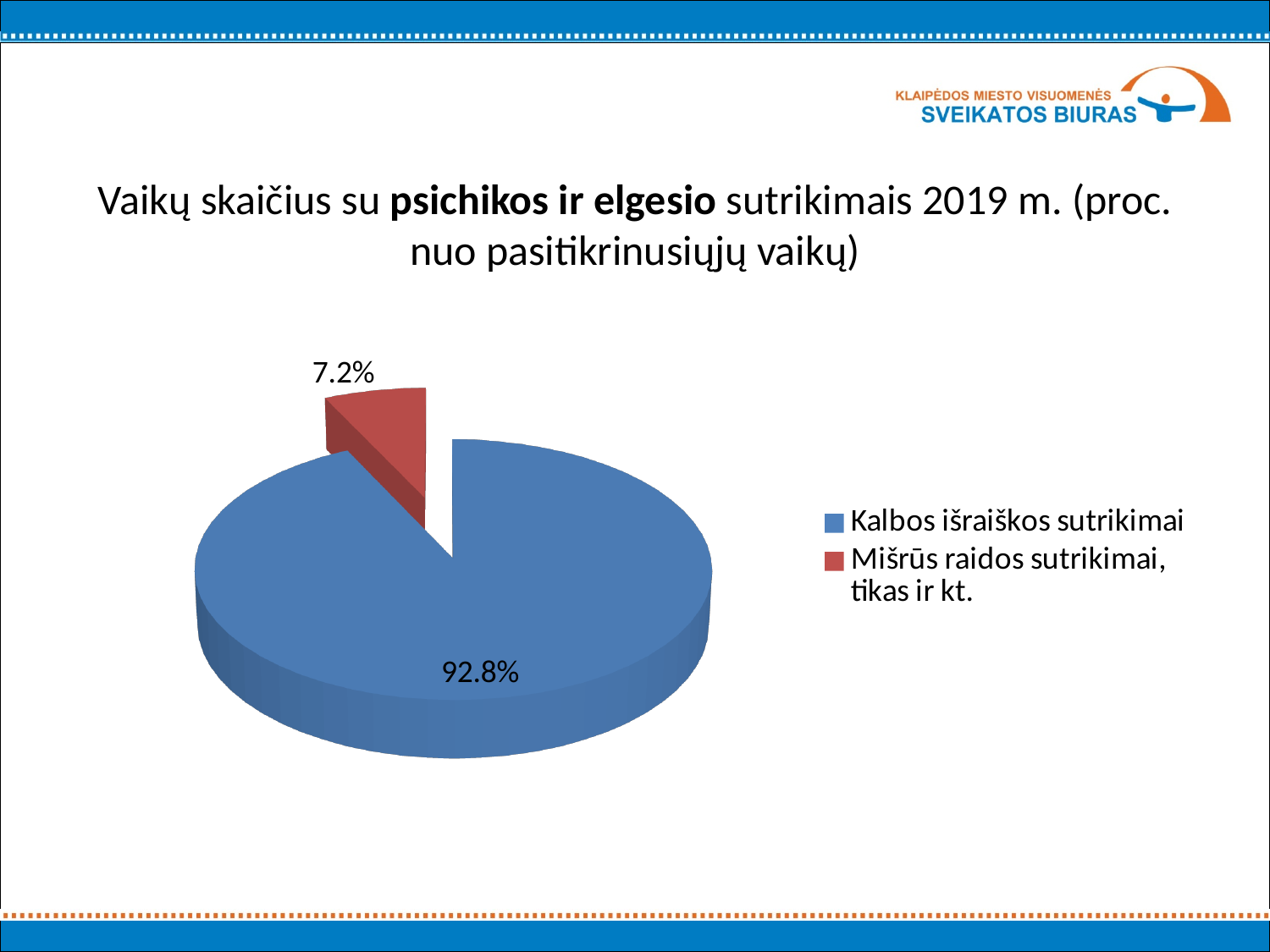
Which category has the largest slice of the pie? Kalbos išraiškos sutrikimai What colour is the slice for "Mišrūs raidos sutrikimai, tikas ir kt."? red Which year does the chart title refer to? 2019 Which category has the smallest slice of the pie? Mišrūs raidos sutrikimai, tikas ir kt. How many slices does the pie chart have? 2 How many entries does the legend list? 2 Which is larger: the slice for "Kalbos išraiškos sutrikimai" or the slice for "Mišrūs raidos sutrikimai, tikas ir kt."? Kalbos išraiškos sutrikimai What share of the pie does "Kalbos išraiškos sutrikimai" take? 92.8% What is the difference in percentage points between the "Kalbos išraiškos sutrikimai" slice and the "Mišrūs raidos sutrikimai, tikas ir kt." slice? 85.6 What kind of chart is shown on the slide? pie chart What share of the pie does "Mišrūs raidos sutrikimai, tikas ir kt." take? 7.2%